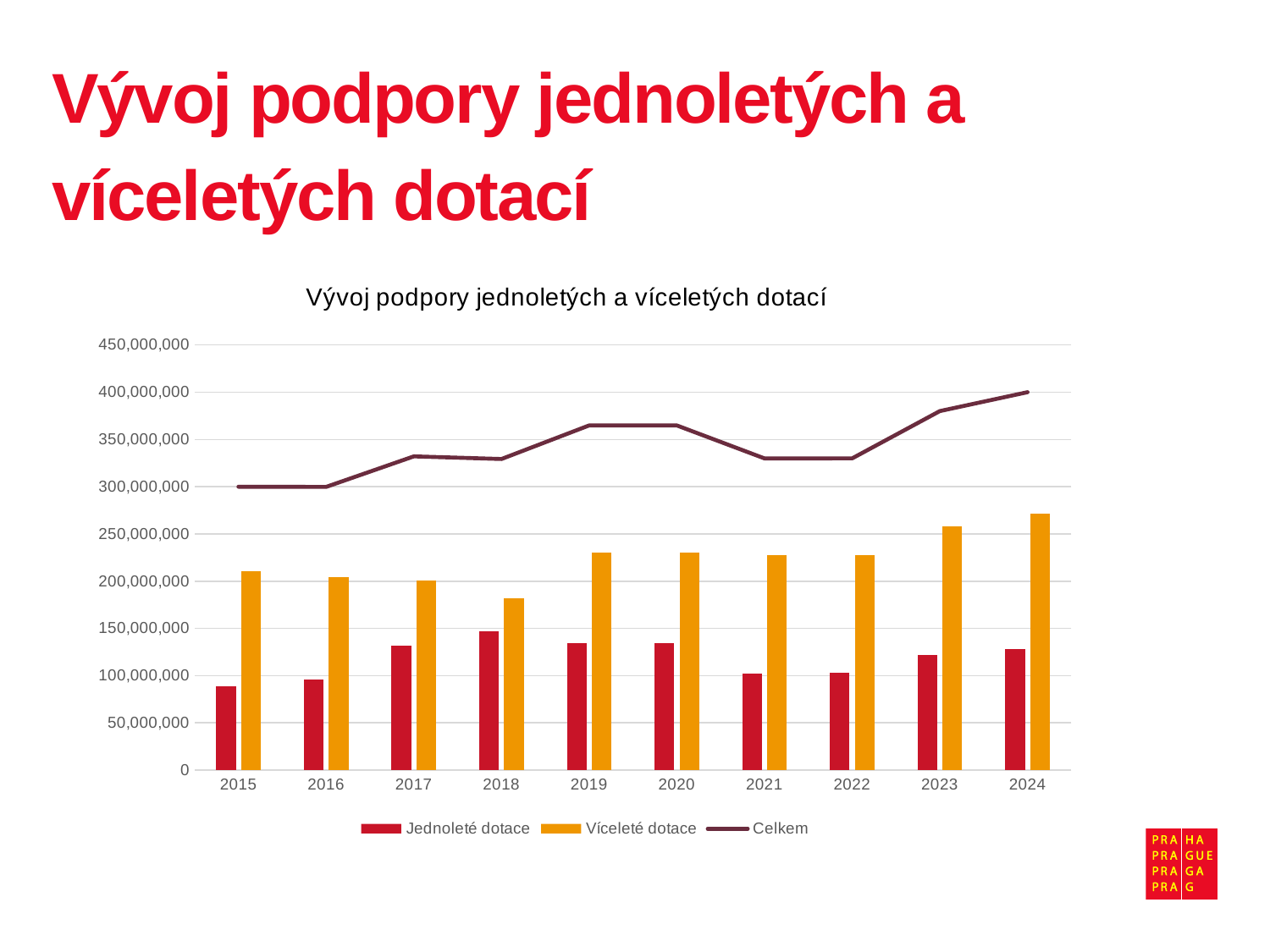
How many series does the chart legend list? 3 In which year is the Jednoleté dotace bar the lowest? 2015 In which year is the Víceleté dotace bar the highest? 2024 What kind of chart is shown on the slide? A combined bar and line chart In which year does the Celkem line reach its highest point? 2024 Which series is drawn as a line in the chart? Celkem Is the value for Jednoleté dotace in 2015 greater or less than 100,000,000? less In 2019, which is larger: Jednoleté dotace or Víceleté dotace? Víceleté dotace Is the value for Celkem in 2023 greater or less than 350,000,000? greater Is the value for Víceleté dotace in 2024 greater or less than 250,000,000? greater How many years are shown on the x axis of the chart? 10 What is the title of the chart? Vývoj podpory jednoletých a víceletých dotací